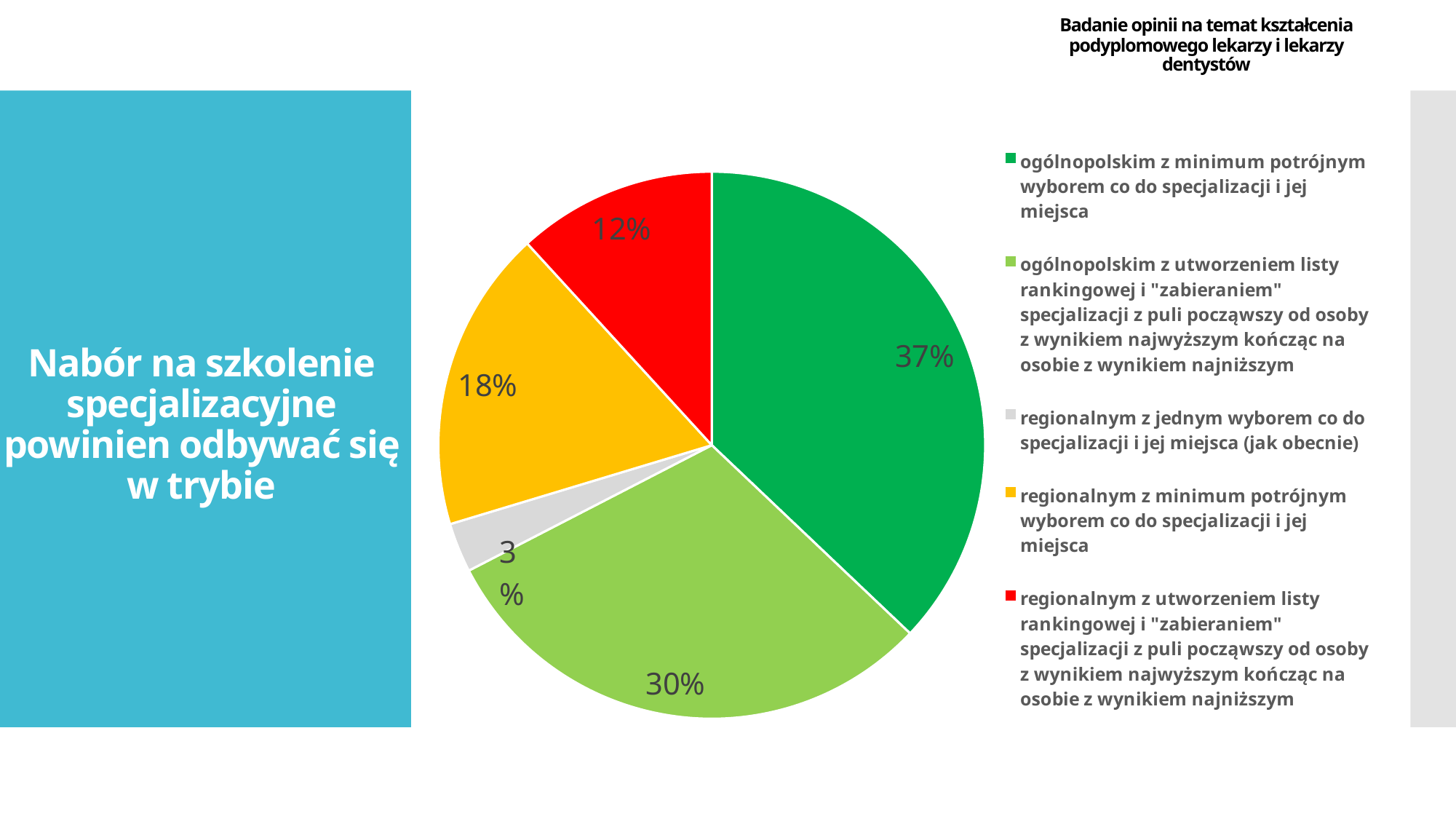
How many slices does the pie chart have? 5 What share of respondents chose "regionalnym z minimum potrójnym wyborem co do specjalizacji i jej miejsca"? 18% What kind of chart is shown on the slide? pie chart What share of respondents chose "regionalnym z utworzeniem listy rankingowej"? 12% Which option has the largest share of the pie? ogólnopolskim z minimum potrójnym wyborem co do specjalizacji i jej miejsca How many entries does the legend list? 5 What is the difference in percentage points between the "ogólnopolskim z minimum potrójnym wyborem" slice and the "regionalnym z minimum potrójnym wyborem" slice? 19 What share of respondents chose "regionalnym z jednym wyborem co do specjalizacji i jej miejsca (jak obecnie)"? 3% What share of respondents chose "ogólnopolskim z utworzeniem listy rankingowej"? 30% Which slice is larger: "regionalnym z minimum potrójnym wyborem" or "regionalnym z utworzeniem listy rankingowej"? regionalnym z minimum potrójnym wyborem Which option has the smallest share of the pie? regionalnym z jednym wyborem co do specjalizacji i jej miejsca (jak obecnie) What share of respondents chose "ogólnopolskim z minimum potrójnym wyborem co do specjalizacji i jej miejsca"? 37%